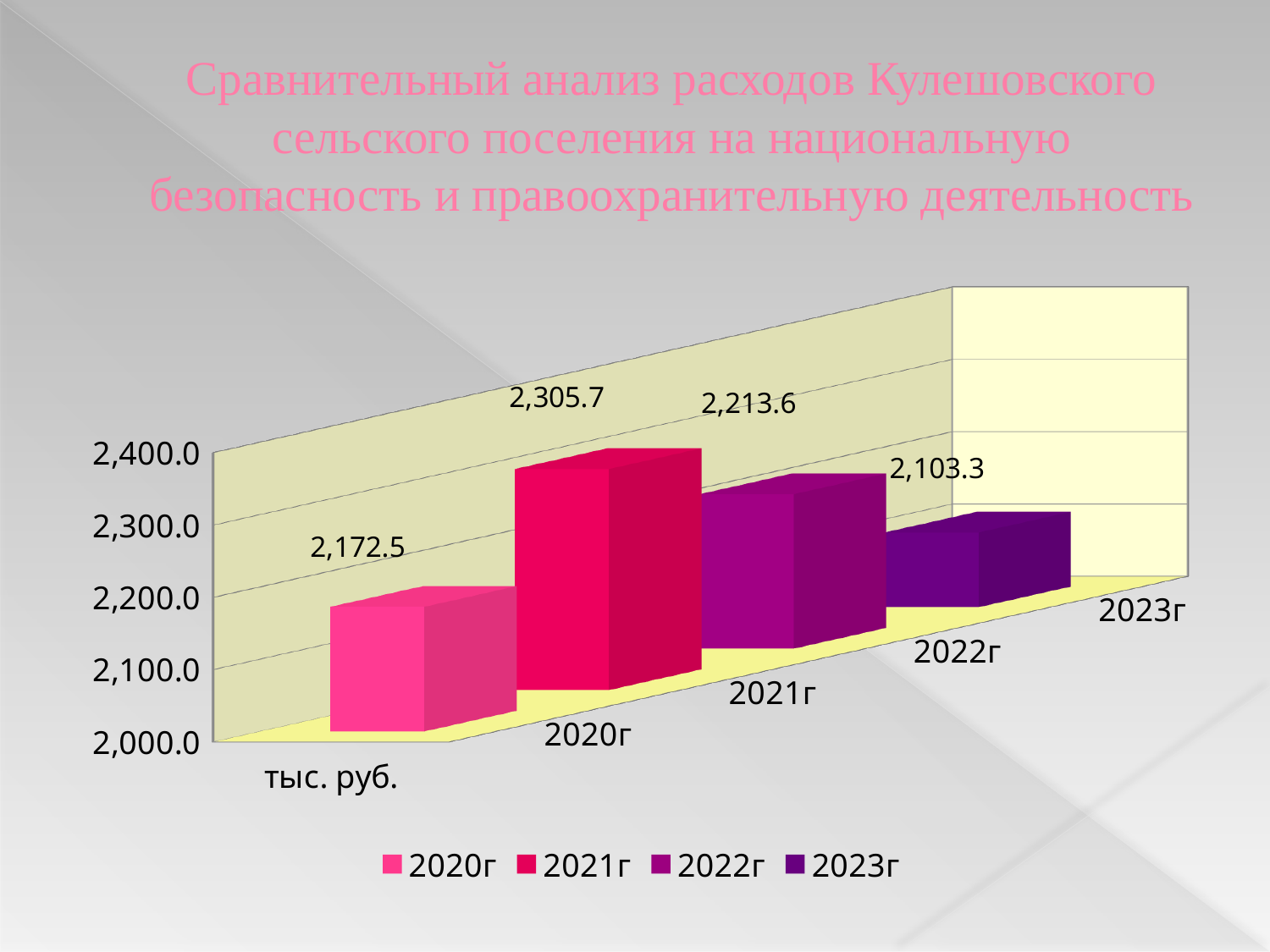
Which is larger, the value for 2022г or the value for 2020г? 2022г Which year has the highest value? 2021г Is the value for 2021г greater or less than 2,300.0? greater What is the difference between the values for 2022г and 2023г? 110.3 What is the value for 2023г? 2,103.3 What is the value for 2021г? 2,305.7 How many bars are plotted on the chart? 4 What kind of chart is shown on the slide? bar chart Which year has the lowest value? 2023г What is the value for 2020г? 2,172.5 What is the difference between the values for 2021г and 2020г? 133.2 How many entries does the legend list? 4